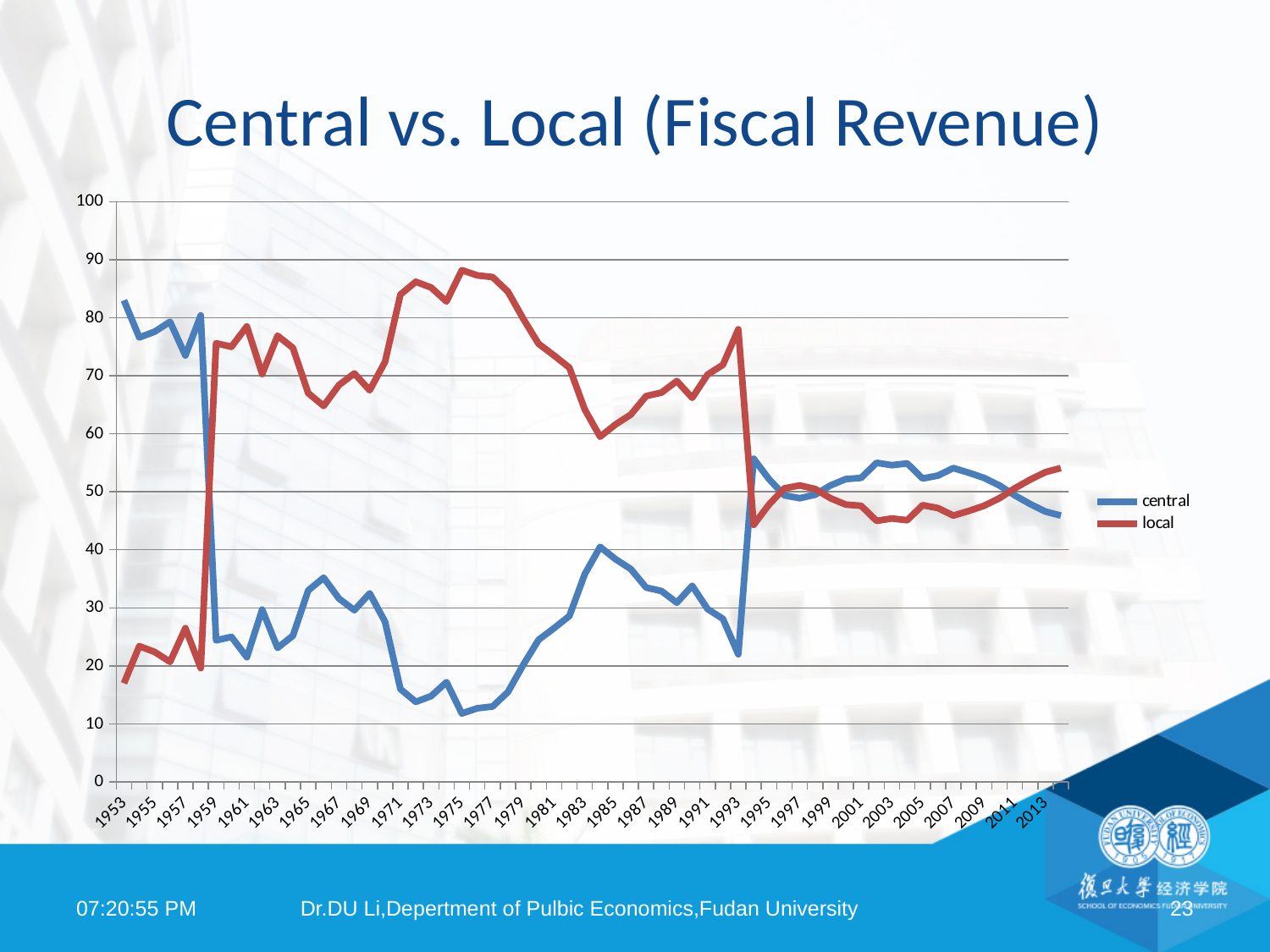
Is the value for central in 1976 greater or less than 20? less Does the central series rise or fall from 1984 to 1993? fall Is the value for central in 1993 greater or less than 30? less What kind of chart is shown on the slide? line chart Which series is drawn in red? local Is the value for central in 1953 greater or less than 70? greater How many series does the legend list? 2 In 1994, which series has the higher value, central or local? central What is the title of the chart? Central vs. Local (Fiscal Revenue) In 1985, which series has the higher value, central or local? local